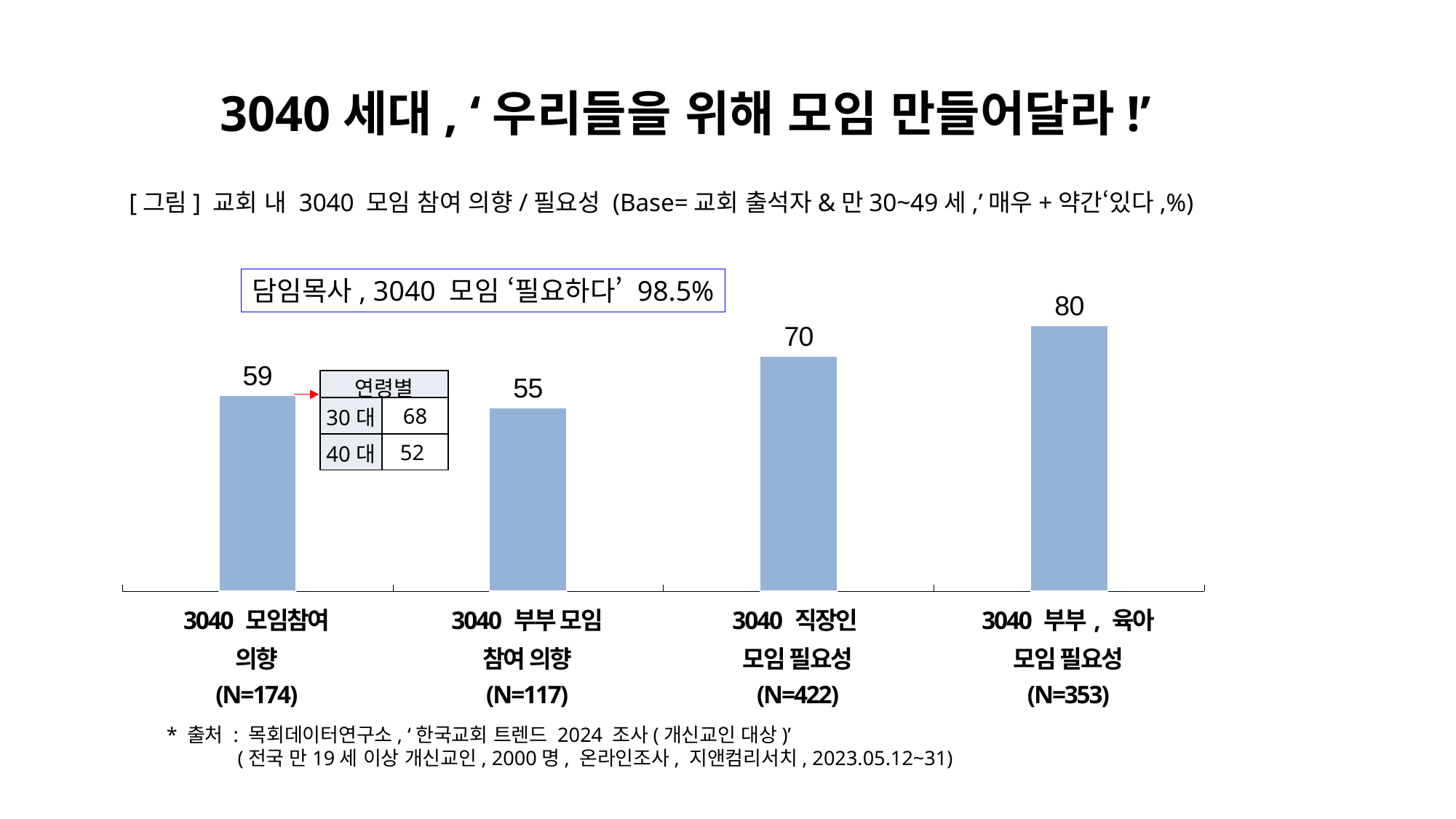
Which category has the lowest value? 3040 부부 모임 참여 의향 (N=117) In the inset table by age group (연령별), what is the value for 30대? 68 What is the difference between the values for '3040 부부, 육아 모임 필요성' and '3040 모임참여 의향'? 21 How many categories are shown in the chart? 4 According to the boxed note on the chart, what percentage of 담임목사 said a 3040 모임 is '필요하다'? 98.5% What is the value for '3040 직장인 모임 필요성 (N=422)'? 70 What kind of chart is shown on the slide? Bar chart Which is larger: the value for '3040 직장인 모임 필요성' or '3040 부부 모임 참여 의향'? 3040 직장인 모임 필요성 Which category has the highest value? 3040 부부, 육아 모임 필요성 (N=353) What is the value for '3040 부부 모임 참여 의향 (N=117)'? 55 What is the value for '3040 부부, 육아 모임 필요성 (N=353)'? 80 What is the value for '3040 모임참여 의향 (N=174)'? 59